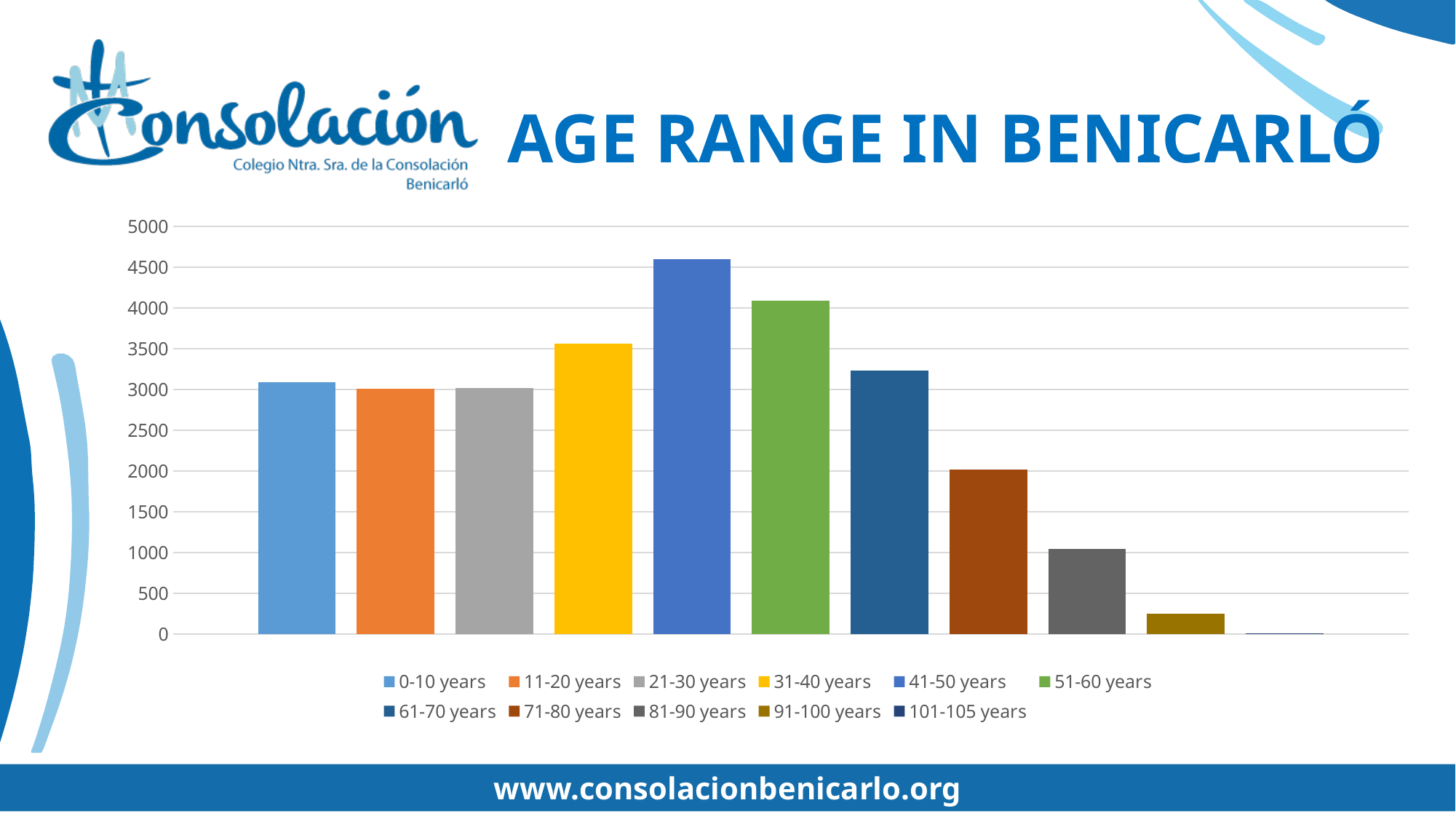
Which age range has the lowest value? 101-105 years How many age-range entries does the legend list? 11 Is the value for 71-80 years greater or less than 2500? less Which age range has the highest value? 41-50 years Is the value for 91-100 years greater or less than 500? less Do the values rise or fall from 41-50 years through 101-105 years? fall Is the value for 51-60 years greater or less than 4000? greater What is the title of the chart on the slide? AGE RANGE IN BENICARLÓ What kind of chart is shown on the slide? bar chart Which is larger, the value for 51-60 years or the value for 61-70 years? 51-60 years How many bars are plotted in the chart? 11